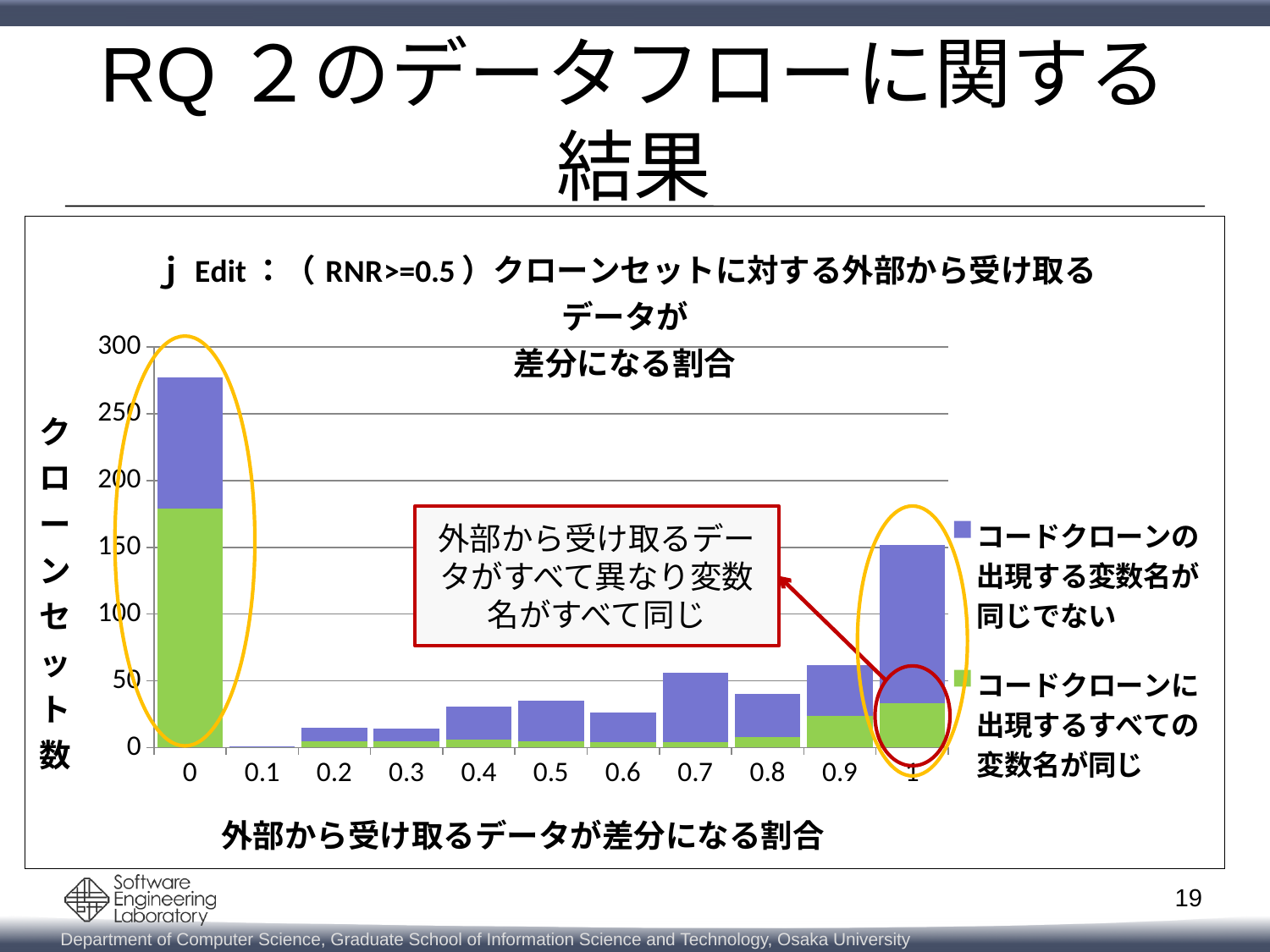
How many categories are shown along the x axis of the chart? 11 Which x-axis category has the shortest stacked bar? 0.1 What kind of chart is shown on the slide? stacked bar chart Is the total stacked bar for category 0 greater or less than 250? greater What is the label of the y axis of the chart? クローンセット数 How many series does the chart's legend list? 2 Which stacked bar is taller, the one for category 0 or the one for category 1? 0 Which stacked bar is taller, the one for category 0.7 or the one for category 0.9? 0.9 Which x-axis category has the tallest stacked bar? 0 Is the green (all variable names same) portion of the bar for category 0 greater or less than 150? greater Is the total stacked bar for category 0.7 greater or less than 100? less